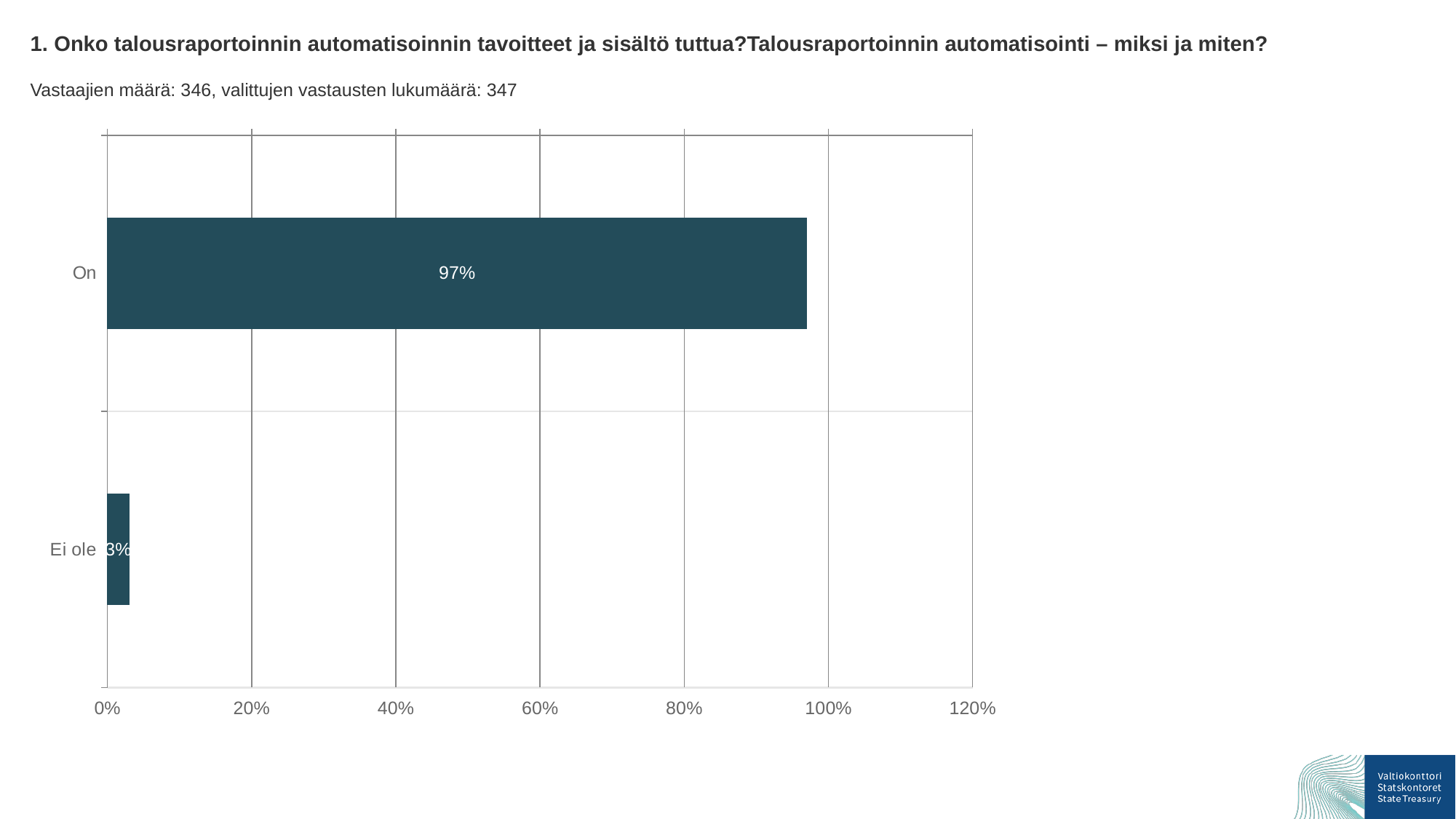
What is the value for "On"? 97% What is the value for "Ei ole"? 3% Which category has the highest value? On How many respondents (Vastaajien määrä) are stated on the slide? 346 What is the maximum value shown on the x axis? 120% Which category has the lowest value? Ei ole What kind of chart is shown on the slide? Bar chart What is the difference between the values for "On" and "Ei ole"? 94% Which is larger, the value for "On" or the value for "Ei ole"? On Is the value for "On" greater or less than 80%? greater How many categories are shown in the chart? 2 Is the value for "Ei ole" greater or less than 20%? less